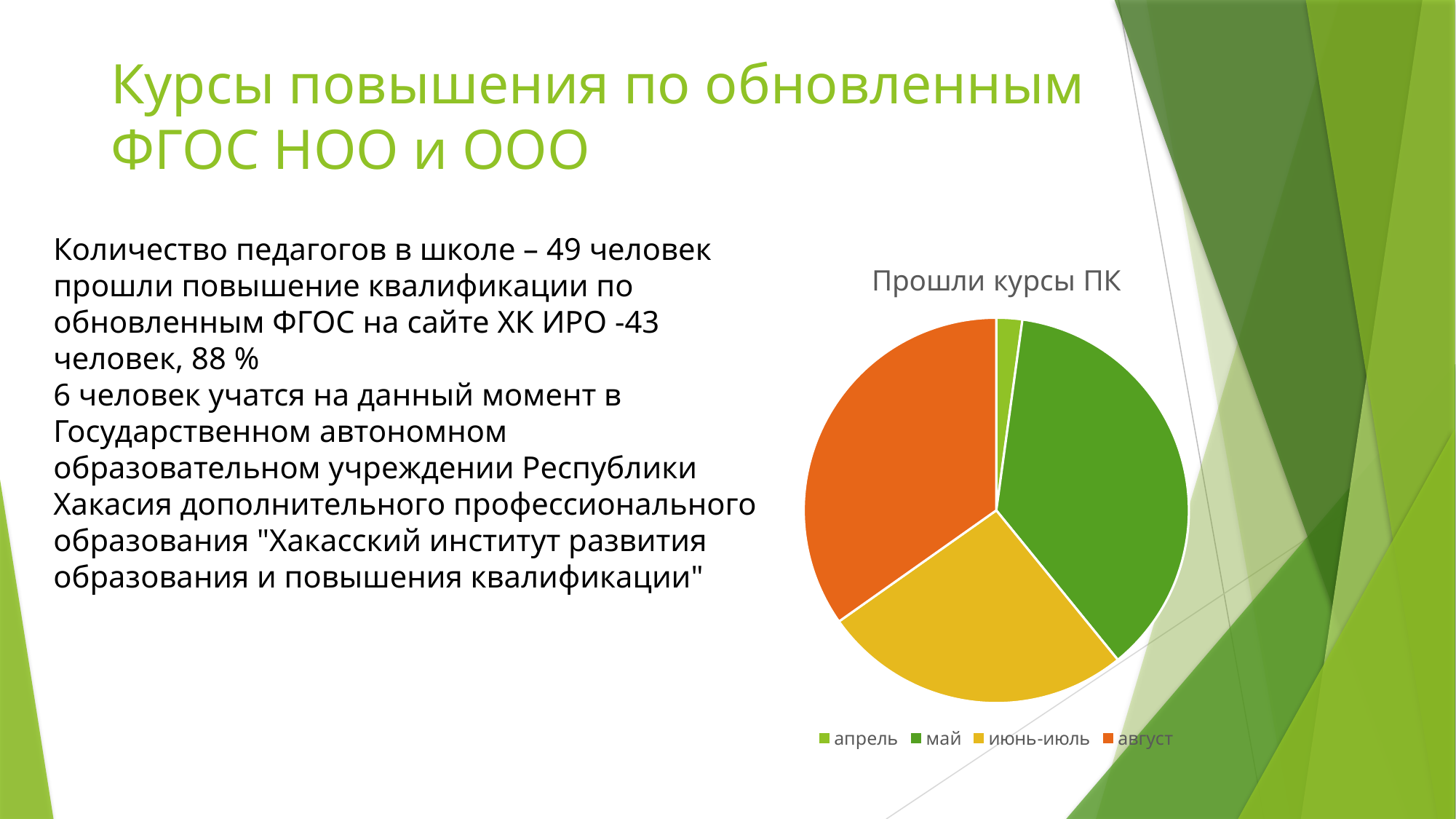
What colour is the slice for август? orange What is the title of the chart? Прошли курсы ПК What kind of chart is shown on the slide? pie chart How many slices does the pie chart have? 4 Which slice is larger, июнь-июль or апрель? июнь-июль Which slice is larger, май or апрель? май Which category has the smallest slice of the pie? апрель Which category has the largest slice of the pie? май Which slice is larger, август or апрель? август How many entries does the chart legend list? 4